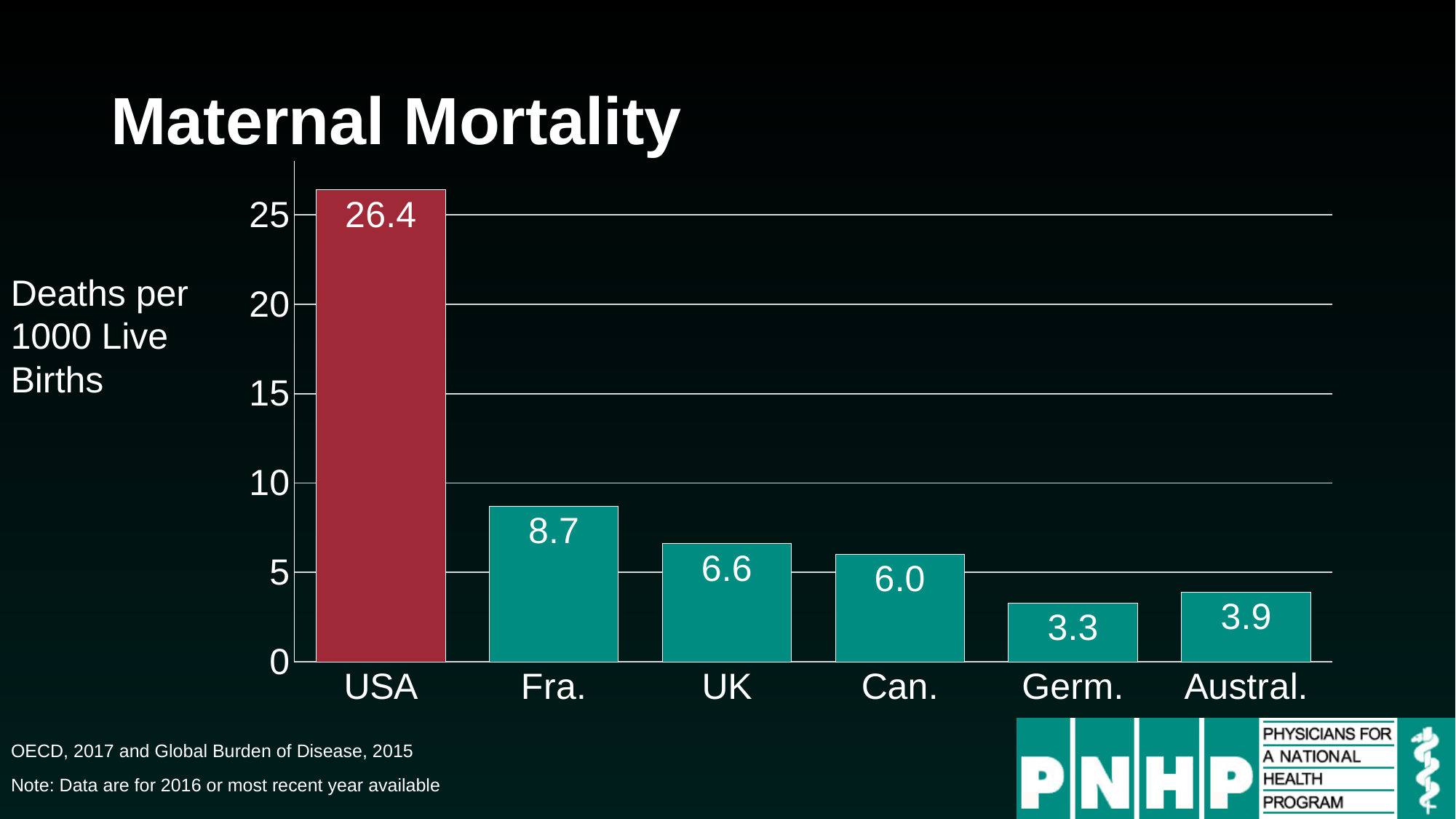
What kind of chart is shown on the slide? bar chart How many countries are shown on the chart? 6 What is the title of the chart? Maternal Mortality What is the value shown for Can.? 6.0 Which country has the highest maternal mortality on the chart? USA What is the difference between the USA value and the Fra. value? 17.7 Is the value for USA greater or less than 25? greater What is the value shown for Germ.? 3.3 What is the difference between the UK value and the Austral. value? 2.7 Which is larger, the value for Fra. or the value for UK? Fra. What is the maternal mortality value for the USA? 26.4 Which country has the lowest maternal mortality on the chart? Germ.